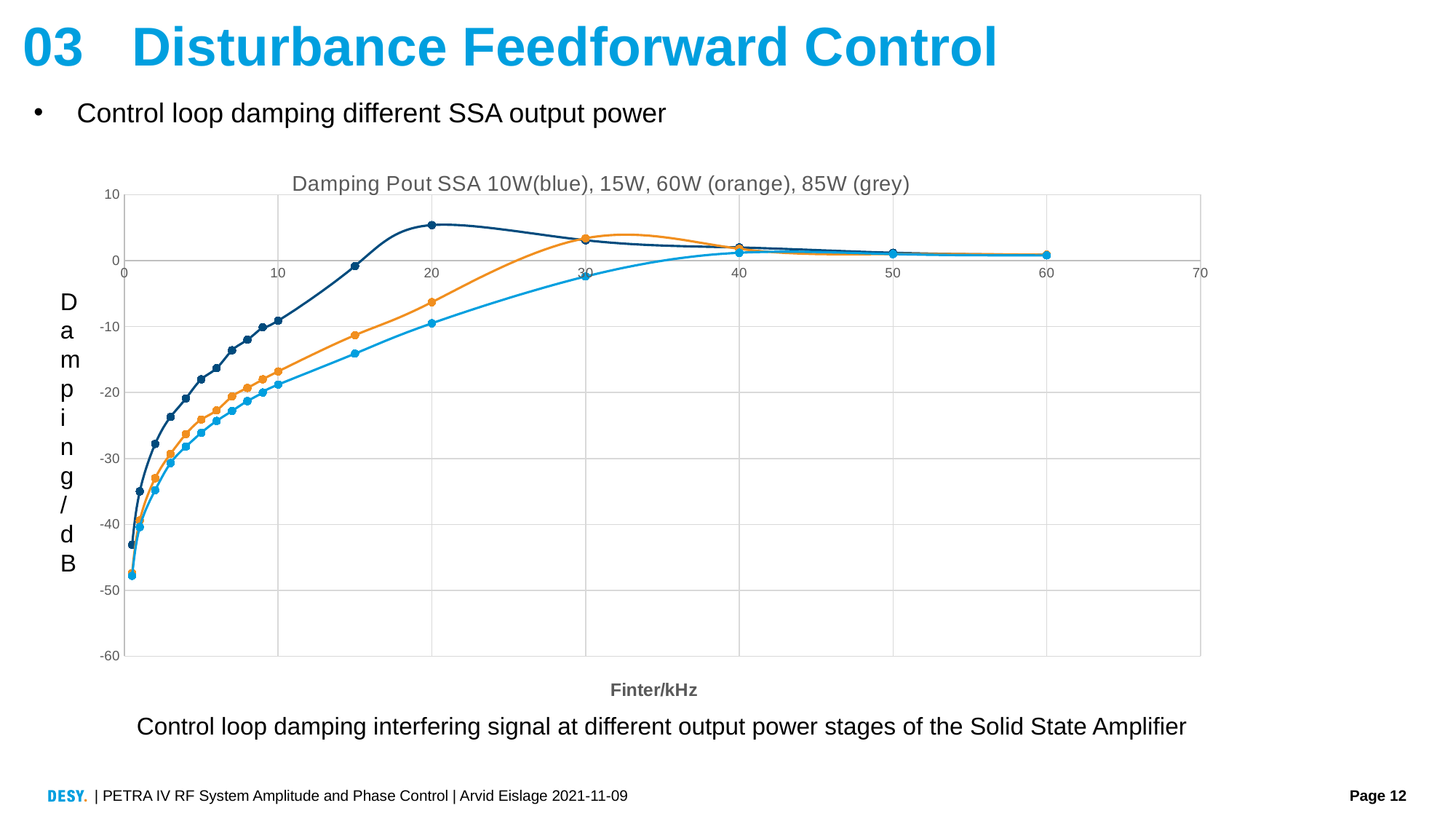
Which line reaches the highest damping value on the chart? dark blue line How many lines are plotted on the chart? 3 At 20 kHz, which line has the higher value, the dark blue line or the orange line? dark blue line Is the value of the orange line at 30 kHz greater or less than 0? greater Do the plotted values generally rise or fall as the frequency increases from 0 to 20 kHz? rise Is the value of the orange line at 20 kHz greater or less than 0? less What is the title of the chart? Damping Pout SSA 10W(blue), 15W, 60W (orange), 85W (grey) Is the value of the dark blue line at 20 kHz greater or less than 0? greater What kind of chart is shown on the slide? line chart What is the label of the x axis of the chart? Finter/kHz